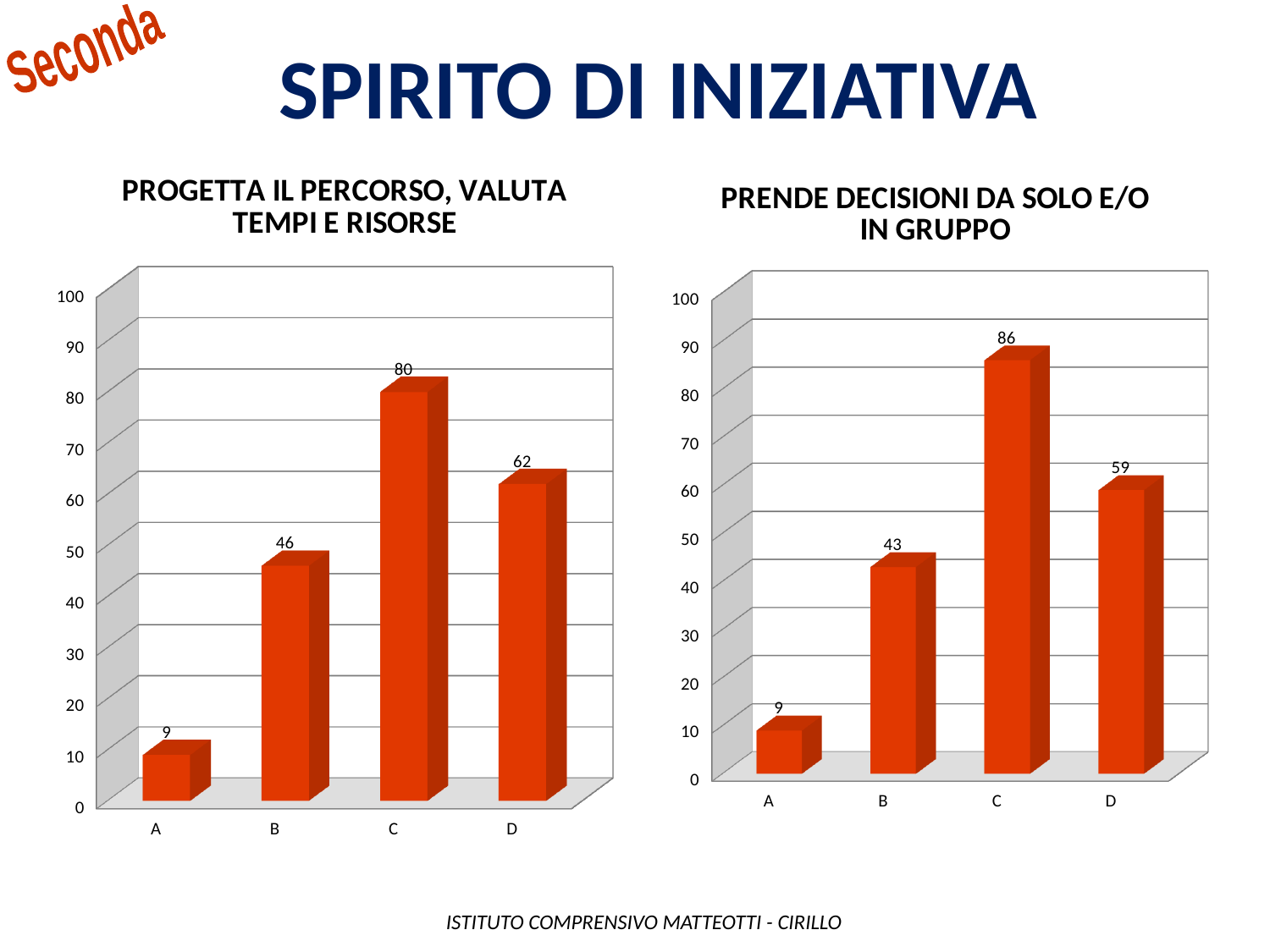
In the chart titled 'PRENDE DECISIONI DA SOLO E/O IN GRUPPO', what is the difference between the values for C and A? 77 In the chart titled 'PROGETTA IL PERCORSO, VALUTA TEMPI E RISORSE', is the value for B greater or less than 50? less In the chart titled 'PRENDE DECISIONI DA SOLO E/O IN GRUPPO', what is the value for category B? 43 In the chart titled 'PROGETTA IL PERCORSO, VALUTA TEMPI E RISORSE', what is the value for category C? 80 In the chart titled 'PRENDE DECISIONI DA SOLO E/O IN GRUPPO', which is larger, the value for B or the value for D? D What is the title of the chart on the right of the slide? PRENDE DECISIONI DA SOLO E/O IN GRUPPO What kind of chart is the chart on the left of the slide? Bar chart How many categories are shown in the chart titled 'PRENDE DECISIONI DA SOLO E/O IN GRUPPO'? 4 In the chart titled 'PROGETTA IL PERCORSO, VALUTA TEMPI E RISORSE', which category has the highest value? C In the chart titled 'PRENDE DECISIONI DA SOLO E/O IN GRUPPO', which category has the lowest value? A In the chart titled 'PROGETTA IL PERCORSO, VALUTA TEMPI E RISORSE', what is the difference between the values for C and D? 18 In the chart titled 'PROGETTA IL PERCORSO, VALUTA TEMPI E RISORSE', what is the value for category A? 9